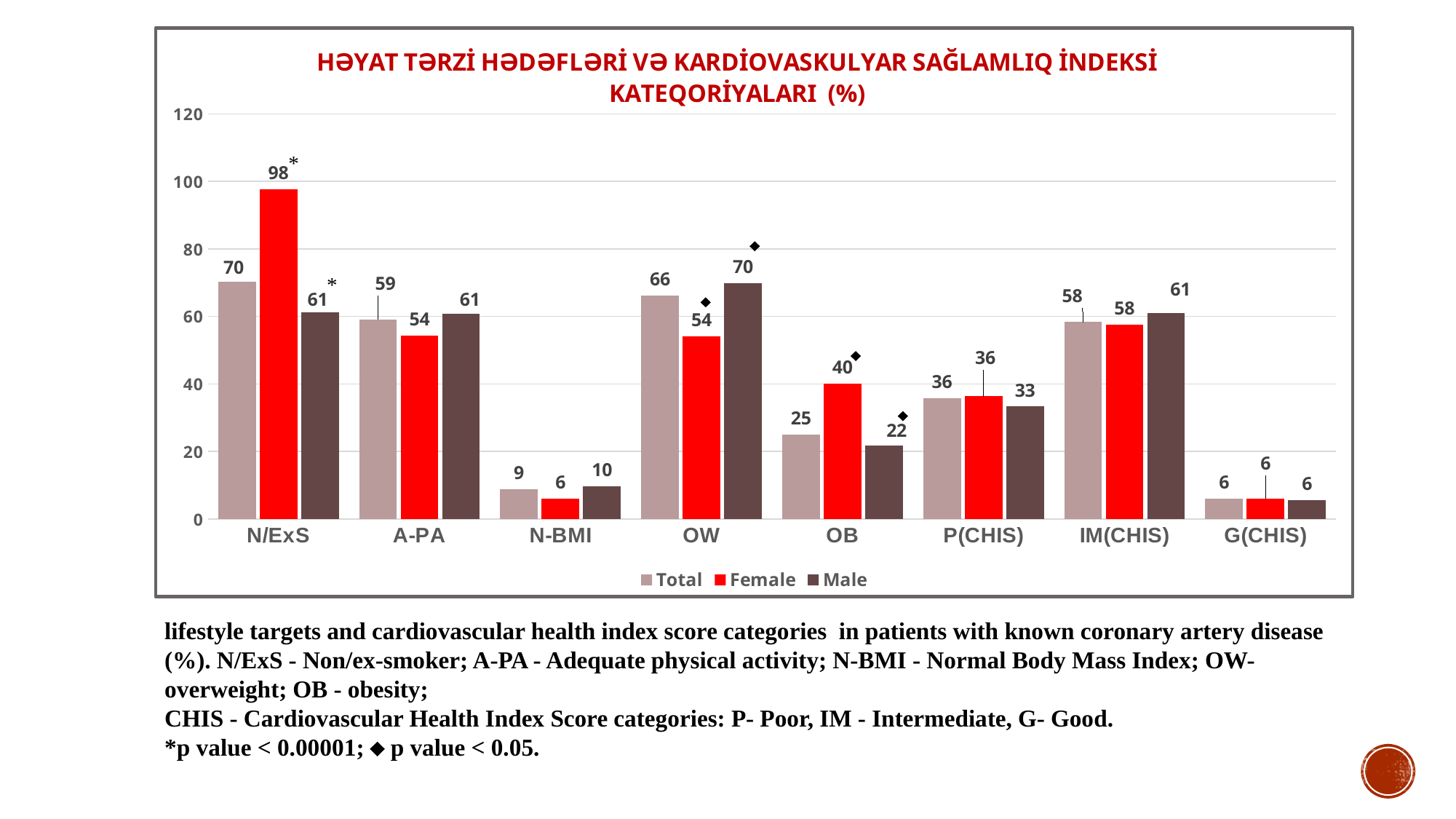
Which is larger for OB, the Female value or the Male value? Female How many categories are shown on the x axis? 8 What is the Total value for OB? 25 Which category has the lowest Total value? G(CHIS) What is the difference between the Total values for OW and OB? 41 What is the Female value for N/ExS? 98 What is the Male value for OW? 70 What kind of chart is shown on the slide? Bar chart Which category has the highest Female value? N/ExS What is the difference between the Female and Male values for N/ExS? 37 How many series does the legend list? 3 Which series is shown in red in the legend? Female